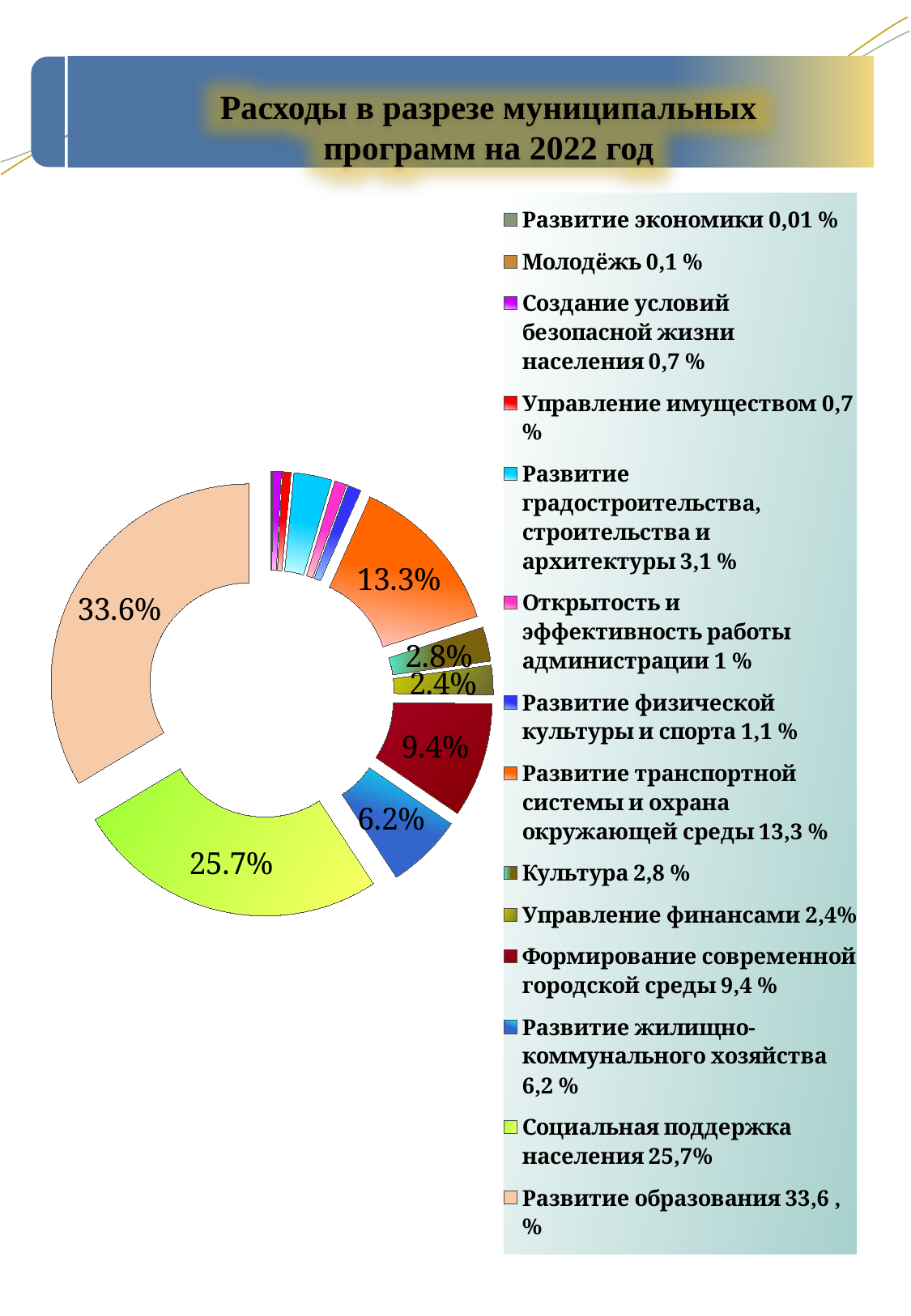
What share of expenditure goes to Социальная поддержка населения? 25.7% What share of expenditure goes to Развитие образования? 33.6% Which municipal programme has the largest share of expenditure? Развитие образования What is the combined share of Развитие образования and Социальная поддержка населения? 59.3% What share is shown for Формирование современной городской среды? 9.4% What kind of chart is shown on the slide? Doughnut (pie) chart What share is shown for Развитие транспортной системы и охрана окружающей среды? 13.3% What share is shown for Культура? 2.8% How many percentage points larger is the share for Развитие образования than for Социальная поддержка населения? 7.9 Which municipal programme has the smallest share of expenditure? Развитие экономики How many municipal programmes are listed in the legend? 14 Which is larger: the share for Формирование современной городской среды or for Развитие жилищно-коммунального хозяйства? Формирование современной городской среды